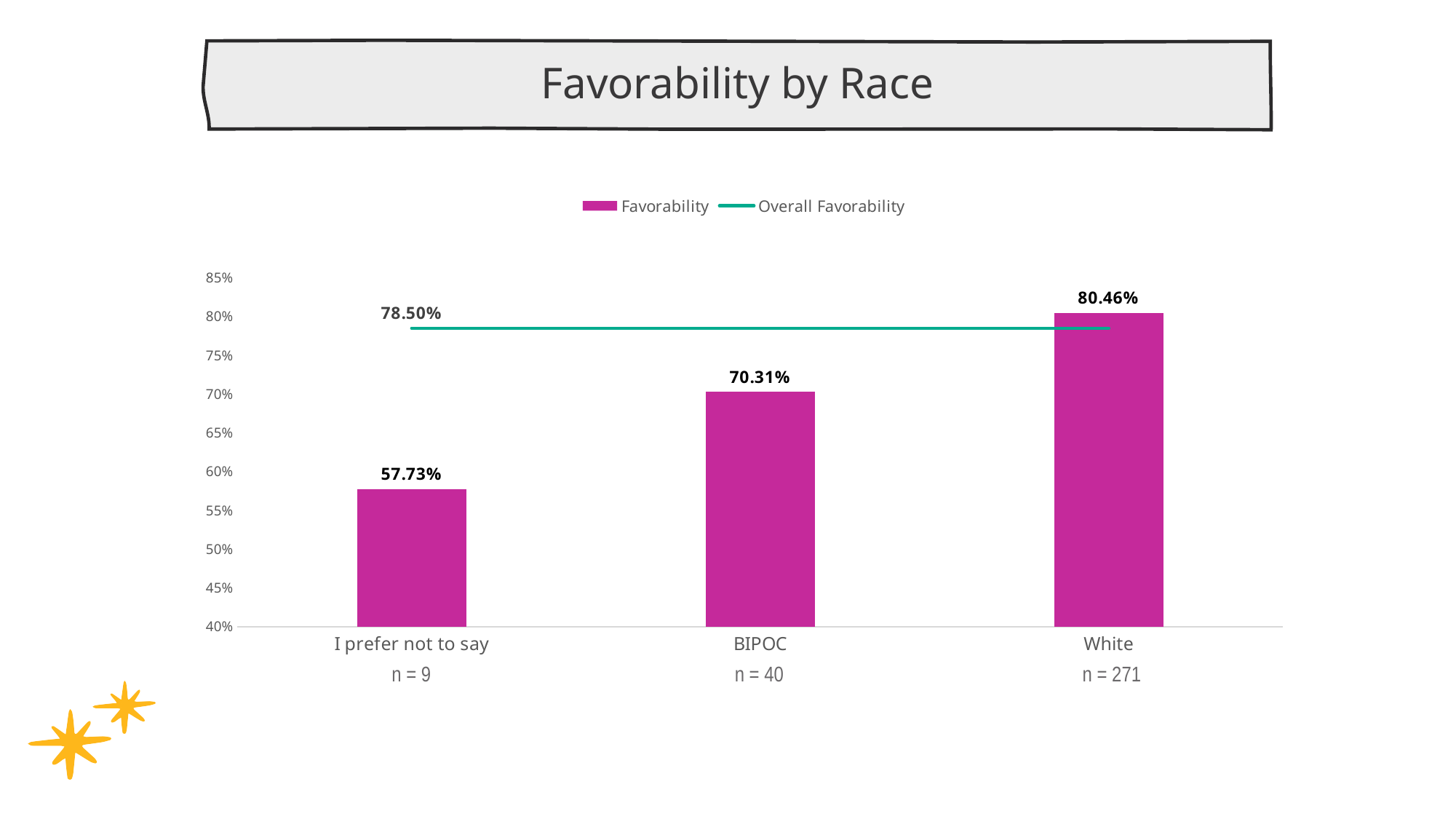
How many categories are shown on the x axis? 3 Do the favorability bars rise or fall from left to right? Rise Which category has the lowest favorability? I prefer not to say What is the favorability value for White? 80.46% What is the favorability value for BIPOC? 70.31% How many series does the legend list? 2 What is the favorability value for 'I prefer not to say'? 57.73% What kind of chart is this? Bar chart with a line Which category has the highest favorability? White What is the Overall Favorability value shown by the line? 78.50% What is the difference in favorability between White and BIPOC? 10.15 percentage points Which is larger, the favorability for BIPOC or the Overall Favorability? Overall Favorability